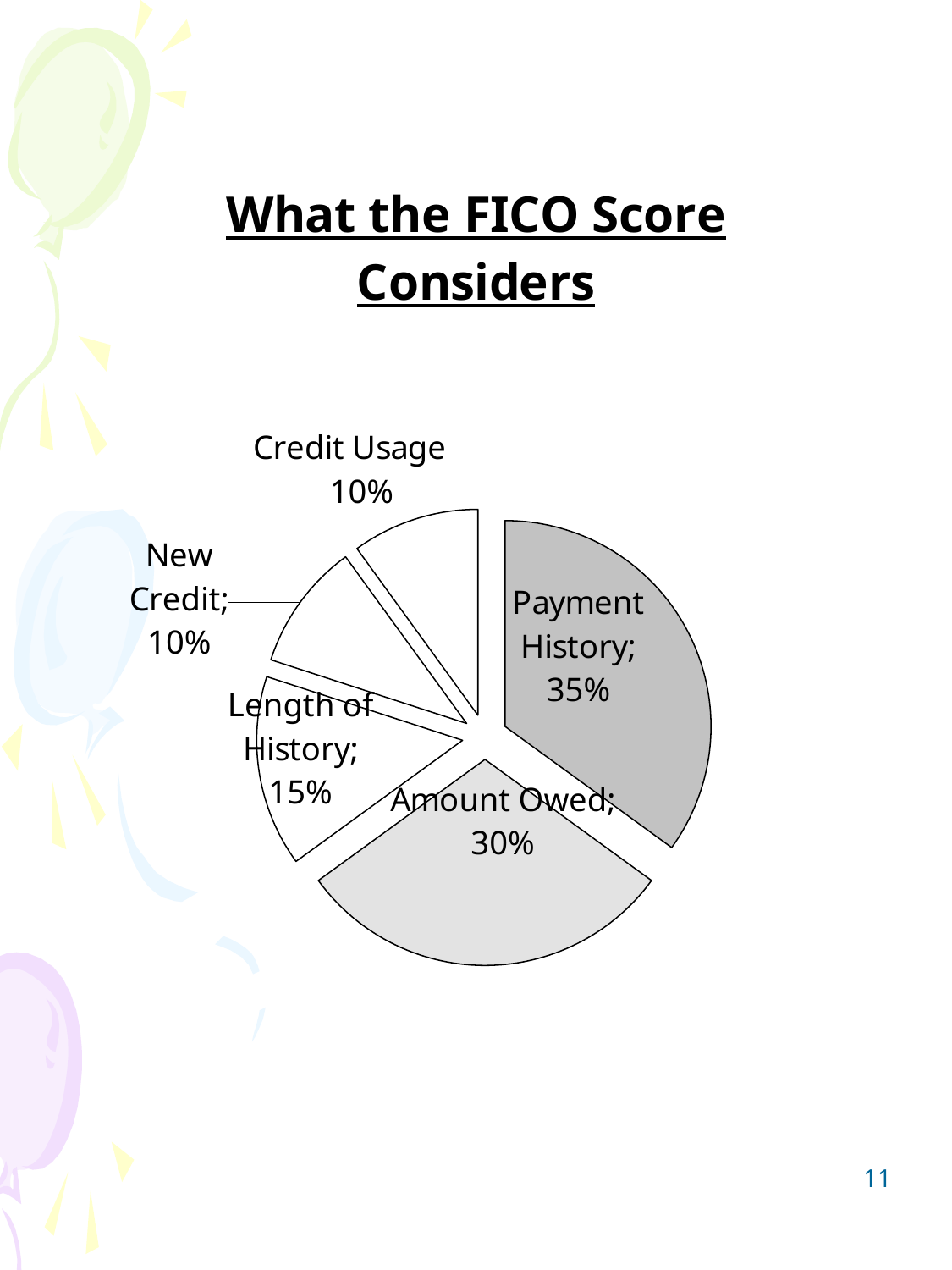
What percentage is shown for Amount Owed? 30% What kind of chart is shown on the slide? pie chart Which is larger, Length of History or New Credit? Length of History What percentage is shown for New Credit? 10% What is the title of the chart on the slide? What the FICO Score Considers What percentage is shown for Length of History? 15% What is the difference between Amount Owed and Length of History? 15% Which category has the largest slice of the pie? Payment History What is the difference in percentage points between Payment History and Amount Owed? 5% How many slices does the pie chart have? 5 What share of the FICO score does Payment History account for? 35% What percentage is shown for Credit Usage? 10%